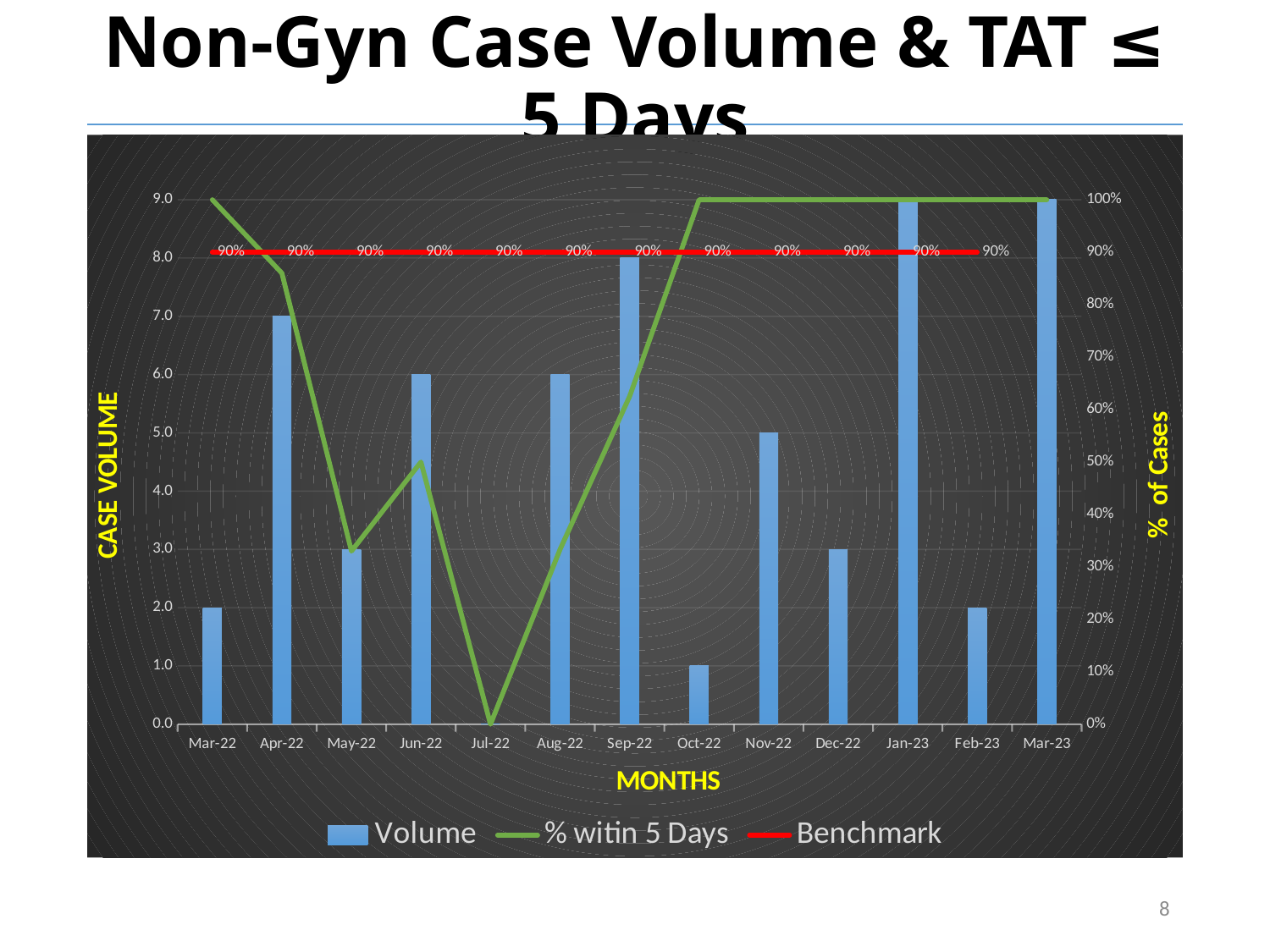
What is the case volume for Apr-22? 7.0 Which month has the larger case volume, Apr-22 or May-22? Apr-22 How many series does the legend list? 3 How many months are shown on the x axis? 13 Is the % within 5 Days value for May-22 greater or less than 40%? less What is the case volume for Sep-22? 8.0 Is the % within 5 Days value for Oct-22 greater or less than 90%? greater Does the % within 5 Days line rise or fall from Mar-22 to Jul-22? fall What value is the Benchmark line set at? 90% What is the title of the x axis? MONTHS What is the difference in case volume between Sep-22 and Oct-22? 7.0 What kind of chart is shown on the slide? bar and line chart